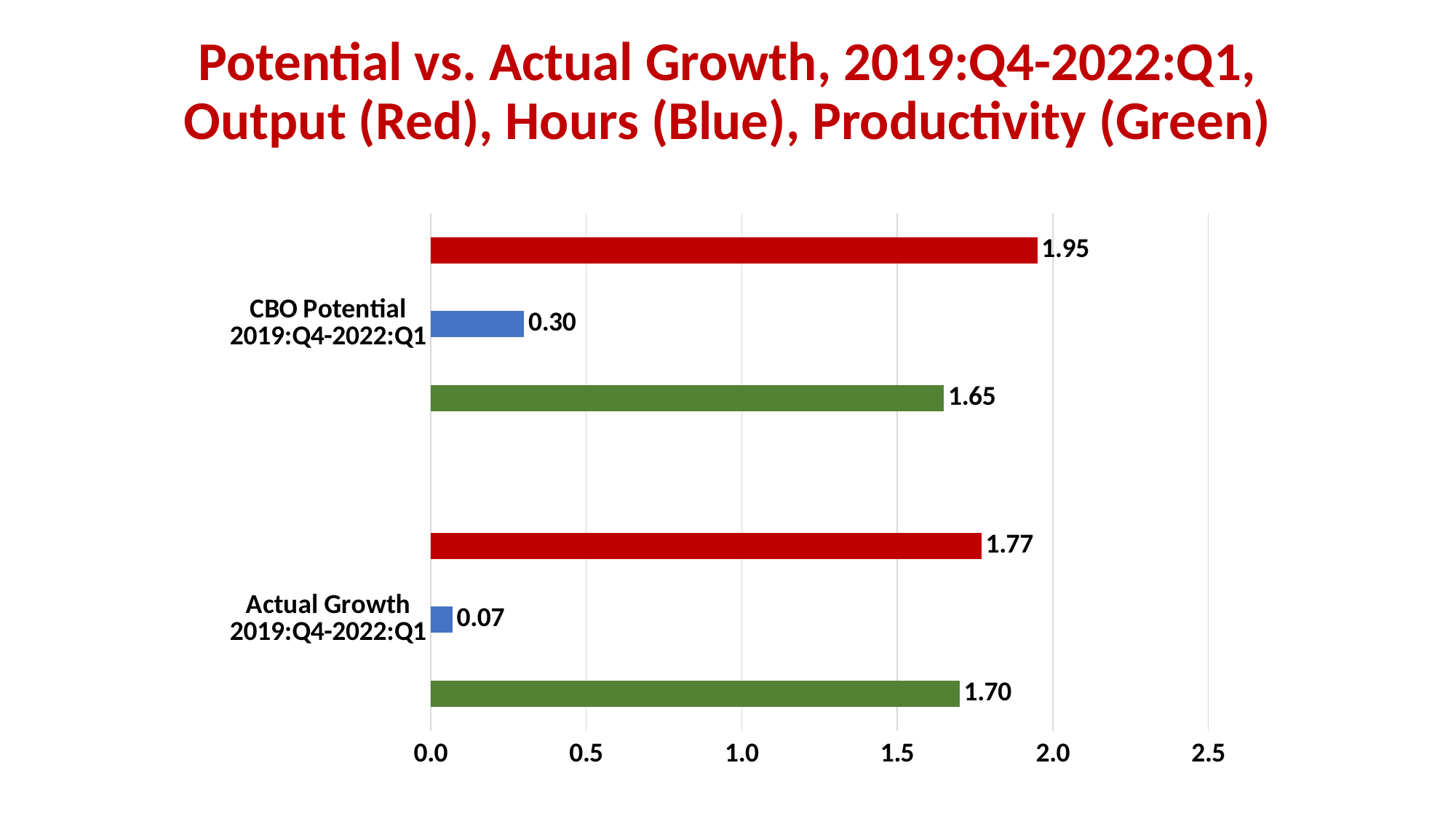
According to the title, which colour represents Hours? Blue What is the Productivity (green) value for CBO Potential 2019:Q4-2022:Q1? 1.65 What is the difference between the Output values for CBO Potential and Actual Growth? 0.18 What is the difference between the Hours values for CBO Potential and Actual Growth? 0.23 What kind of chart is shown on the slide? Bar chart How many categories are shown on the chart? 2 Which is larger: Productivity for CBO Potential or Productivity for Actual Growth? Productivity for Actual Growth Which bar has the highest value on the chart? Output (red) for CBO Potential 2019:Q4-2022:Q1 What is the Output (red) value for Actual Growth 2019:Q4-2022:Q1? 1.77 What is the Output (red) value for CBO Potential 2019:Q4-2022:Q1? 1.95 What is the Hours (blue) value for Actual Growth 2019:Q4-2022:Q1? 0.07 Which bar has the lowest value on the chart? Hours (blue) for Actual Growth 2019:Q4-2022:Q1